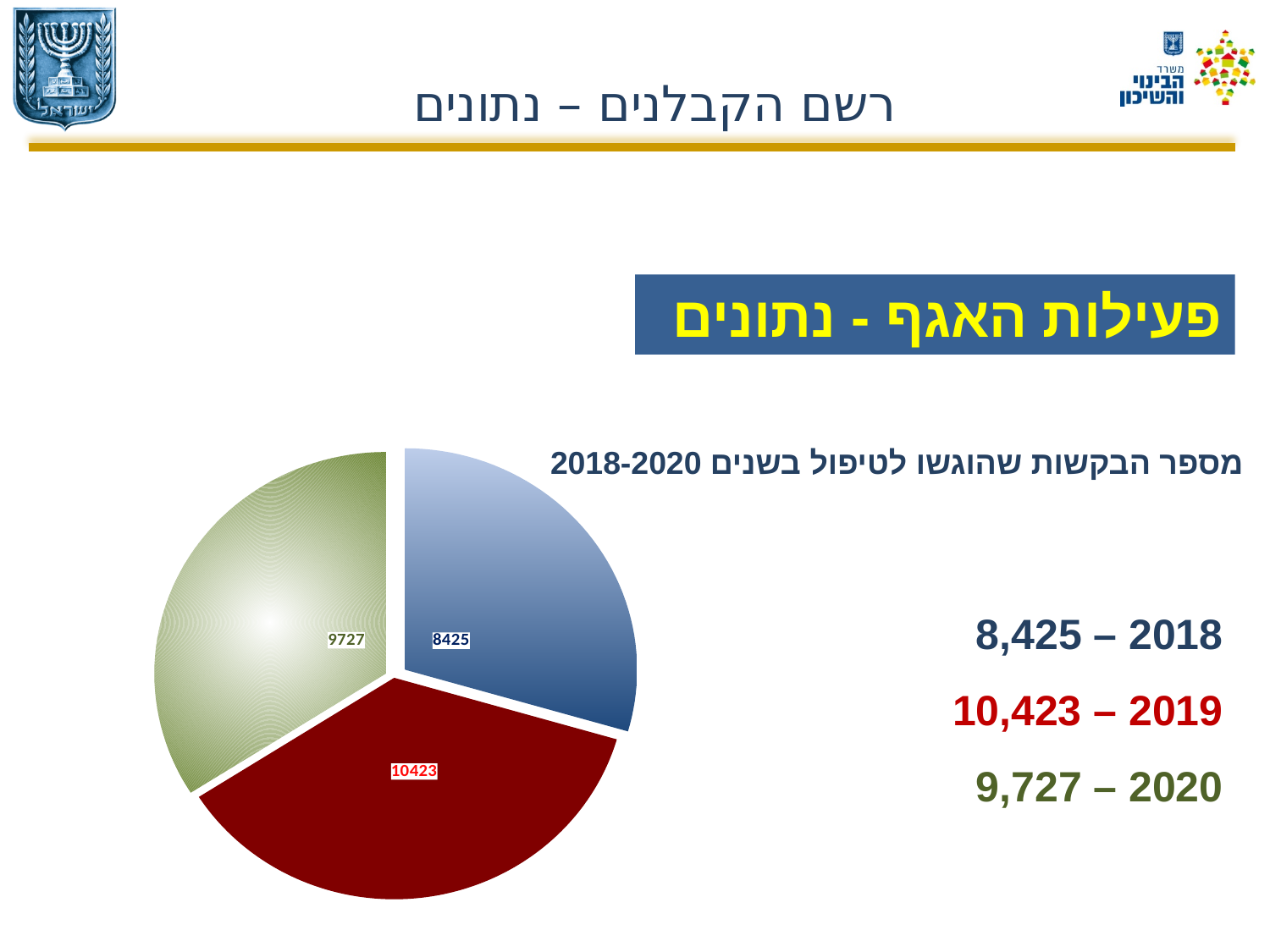
According to the text beside the chart, which year does the red slice (10423) correspond to? 2019 How many slices does the pie chart have? 3 What value is labelled on the blue slice of the pie chart? 8425 What value is labelled on the green slice of the pie chart? 9727 What value is labelled on the red slice of the pie chart? 10423 What is the difference between the red slice (10423) and the blue slice (8425)? 1998 What is the difference between the red slice (10423) and the green slice (9727)? 696 Which is larger, the green slice or the blue slice? green slice (9727) What kind of chart is shown on the slide? pie chart What is the total of all three slices in the pie chart? 28575 Which slice of the pie chart has the largest value? 10423 (red, 2019) Which slice of the pie chart has the smallest value? 8425 (blue, 2018)